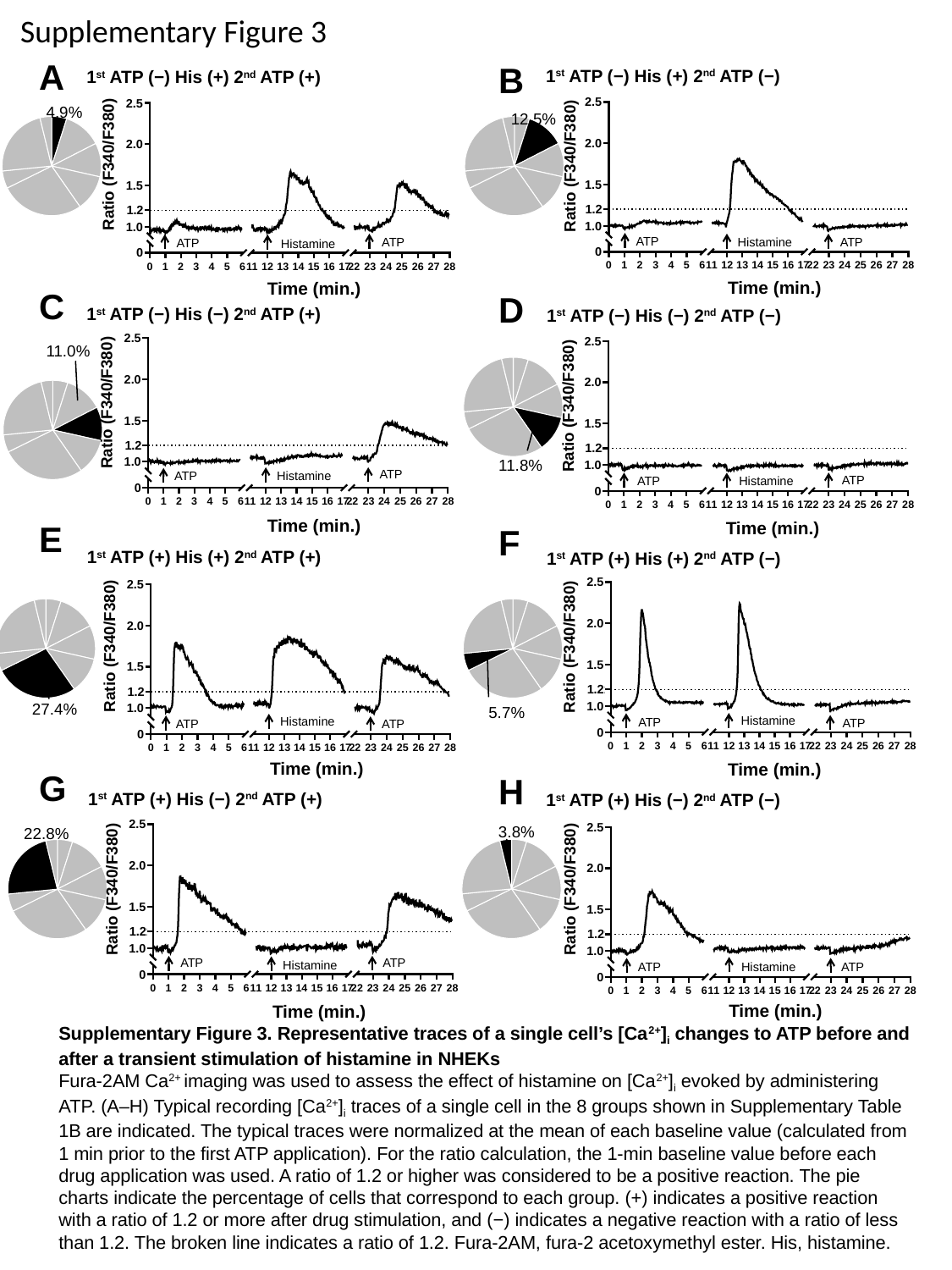
In panel E, what percentage is labelled on the pie chart? 27.4% In panel A, what percentage is labelled on the pie chart? 4.9% What is the difference between the pie chart percentages labelled in panel E and panel G? 4.6 percentage points In the line chart of panel F, is the peak ratio after the histamine application greater or less than 2.0? greater Across the eight pie charts (panels A–H), which panel has the smallest labelled percentage? H (3.8%) Which is larger: the pie chart percentage in panel B or in panel C? Panel B (12.5%) What kind of chart is the trace plot in each panel showing Ratio (F340/F380) against Time (min.)? Line chart In panel G, what percentage is labelled on the pie chart? 22.8% In panel H, what percentage is labelled on the pie chart? 3.8% Across the eight pie charts (panels A–H), which panel has the largest labelled percentage? E (27.4%) How many panels (each with a pie chart and a trace chart) are shown on the slide? 8 In the line chart of panel D, is the ratio after the second ATP application greater or less than 1.2? less